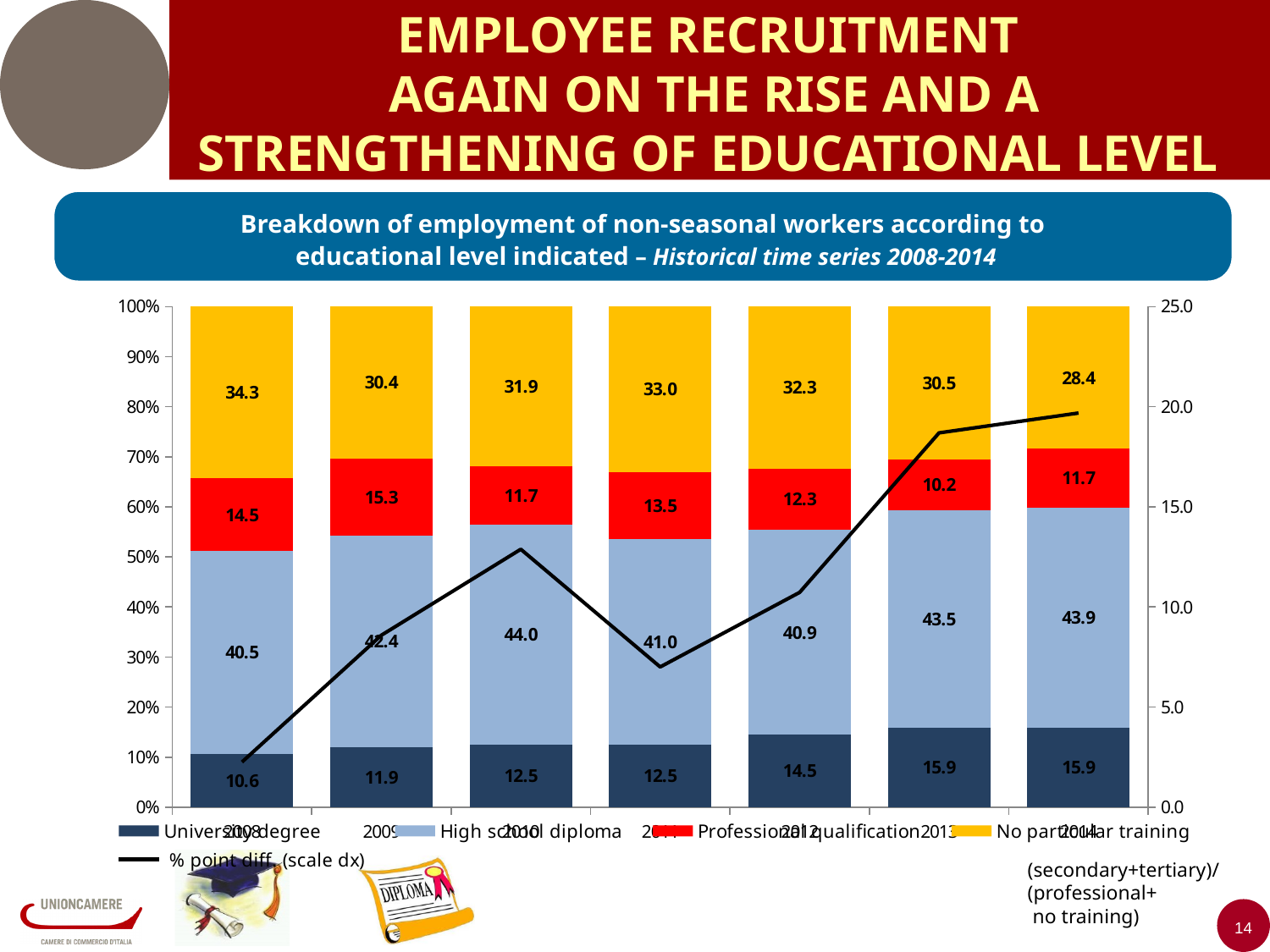
How many years are shown on the x axis? 7 What is the value for University degree in 2008? 10.6 What is the difference between the University degree value in 2014 and in 2008? 5.3 In which year is the Professional qualification share lowest? 2013 Does the University degree share rise or fall from 2008 to 2014? Rises What is the value for No particular training in 2014? 28.4 Which is larger, the High school diploma value in 2010 or in 2012? 2010 In which year is the No particular training share highest? 2008 What kind of chart is this? Stacked bar chart with a line Is the value of the % point diff. line in 2014 greater or less than 15.0 on the right-hand scale? greater What is the value for High school diploma in 2010? 44.0 How many series does the legend list? 5